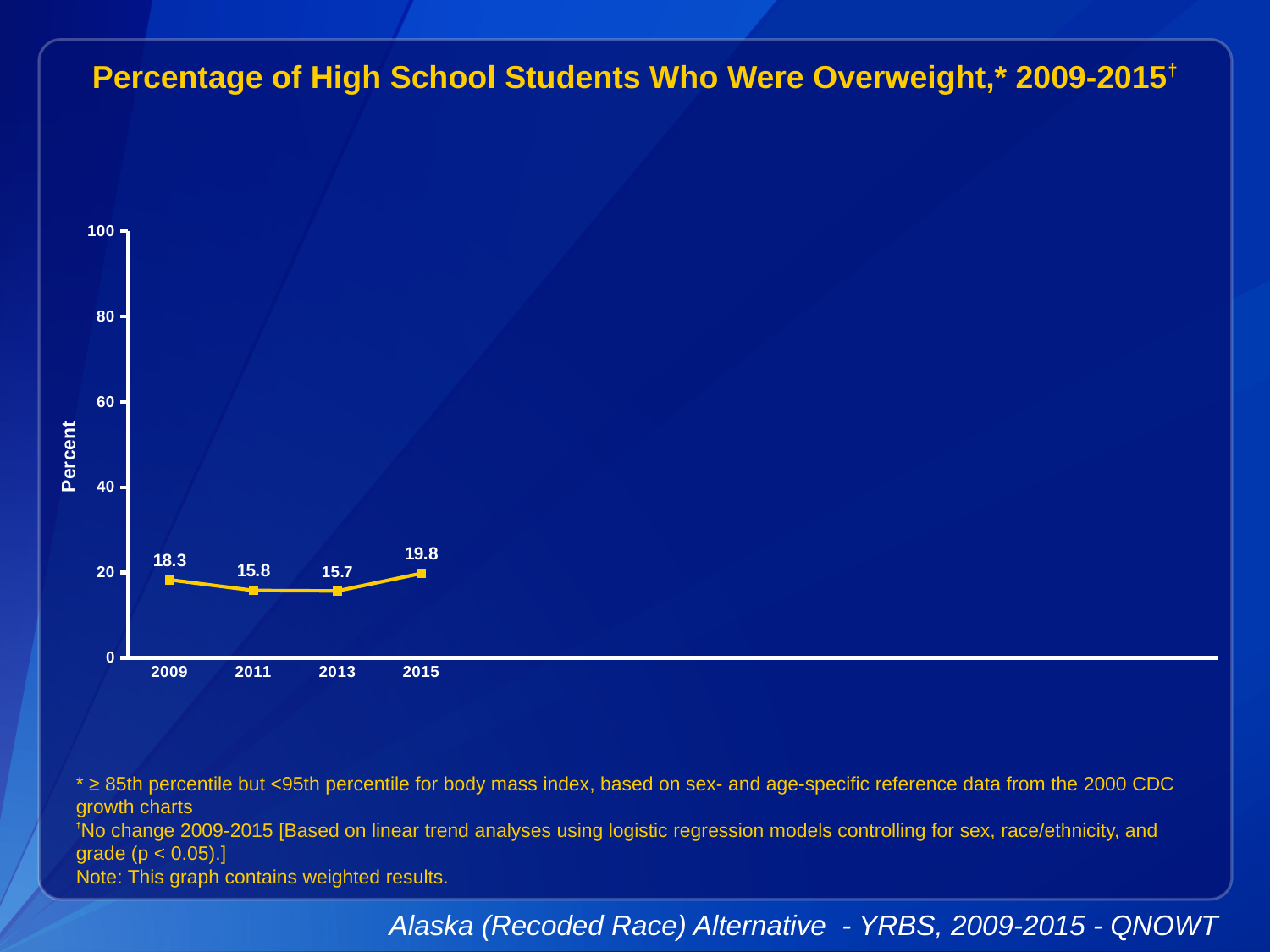
What was the percentage of high school students who were overweight in 2015? 19.8 What kind of chart is shown on the slide? line chart Does the value rise or fall from 2013 to 2015? rise Which year has a larger value, 2009 or 2011? 2009 Which year has the lowest percentage of overweight students? 2013 What is the difference between the 2015 value and the 2009 value? 1.5 Which year has the highest percentage of overweight students? 2015 What value is plotted for 2013? 15.7 Is the value for 2011 greater or less than 20? less What is the label on the vertical axis? Percent What was the percentage of high school students who were overweight in 2009? 18.3 How many years are plotted on the chart? 4